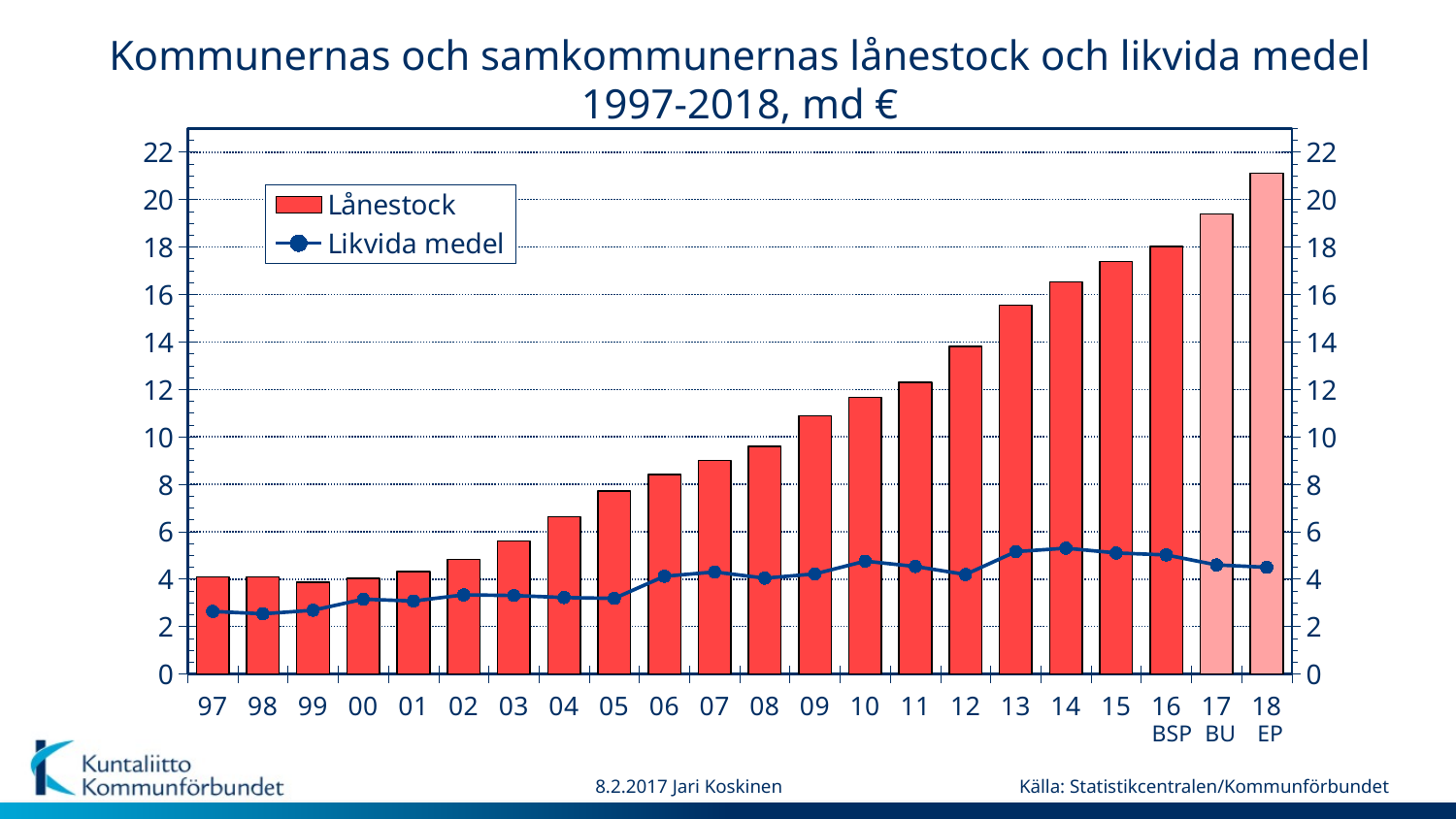
What kind of chart is shown on the slide? A bar chart combined with a line What are the two entries in the legend? Lånestock and Likvida medel Is the Lånestock value for 18 greater or less than 20? greater Is the Lånestock value for 15 greater or less than 16? greater Does the Lånestock series generally rise or fall from 97 to 18? rise Is the Lånestock value for 06 greater or less than 8? greater How many series does the legend list? 2 Which year has the highest Lånestock bar? 18 How many years are shown along the x axis? 22 Which is larger in 08, Lånestock or Likvida medel? Lånestock